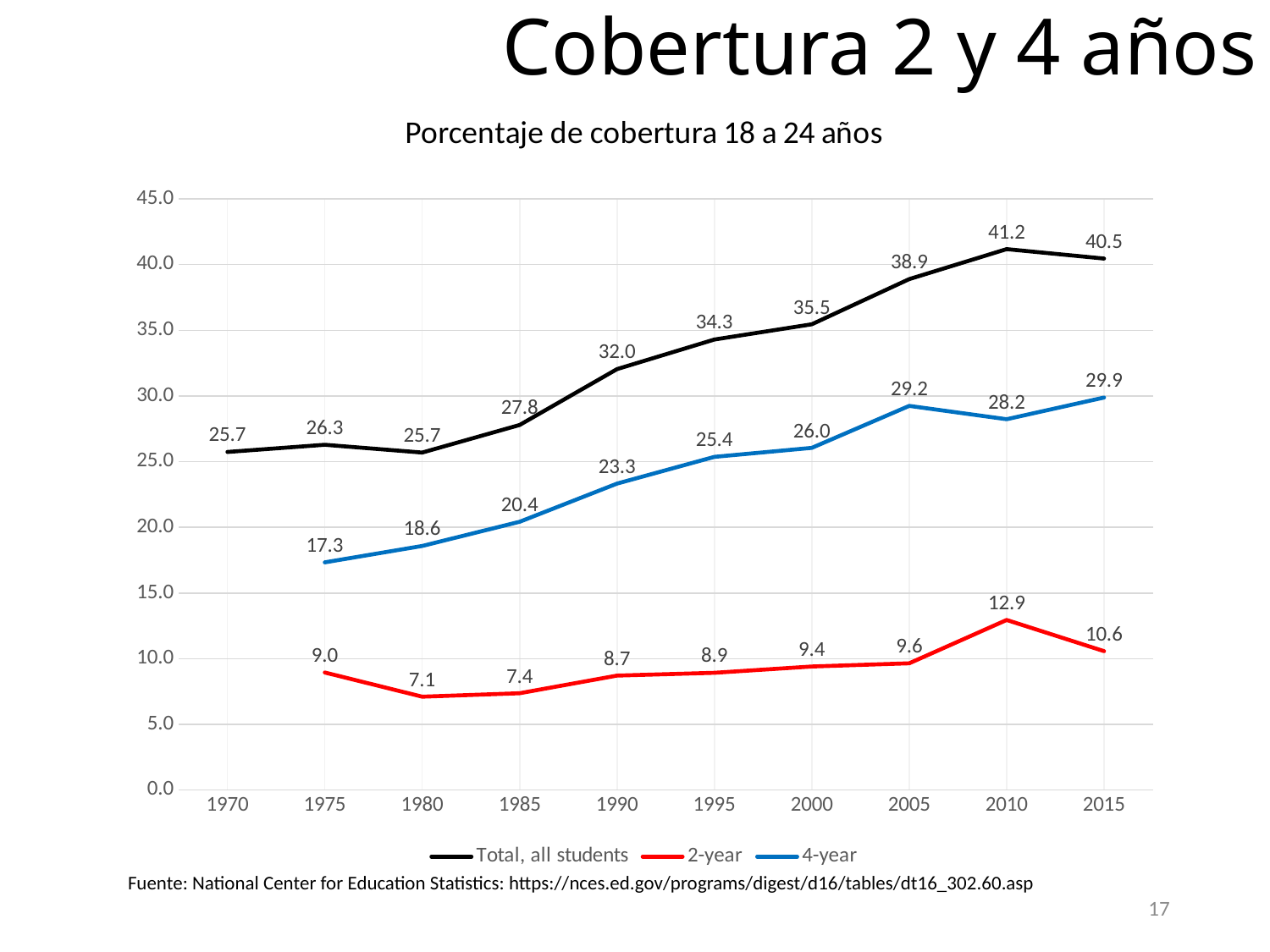
What is the value for the 4-year series in 1975? 17.3 How many years are shown on the x axis? 10 In which year is the 2-year series at its lowest value? 1980 What is the value for the 2-year series in 2015? 10.6 What kind of chart is shown on the slide? Line chart Which is larger in 2005: the 4-year value or the 2-year value? 4-year Does the 4-year series generally rise or fall from 1975 to 2015? Rise What is the value for 'Total, all students' in 2010? 41.2 How many series does the legend list? 3 In which year does the 'Total, all students' series reach its highest value? 2010 What is the difference between the 4-year value and the 2-year value in 2015? 19.3 What colour is the line for the 2-year series? Red